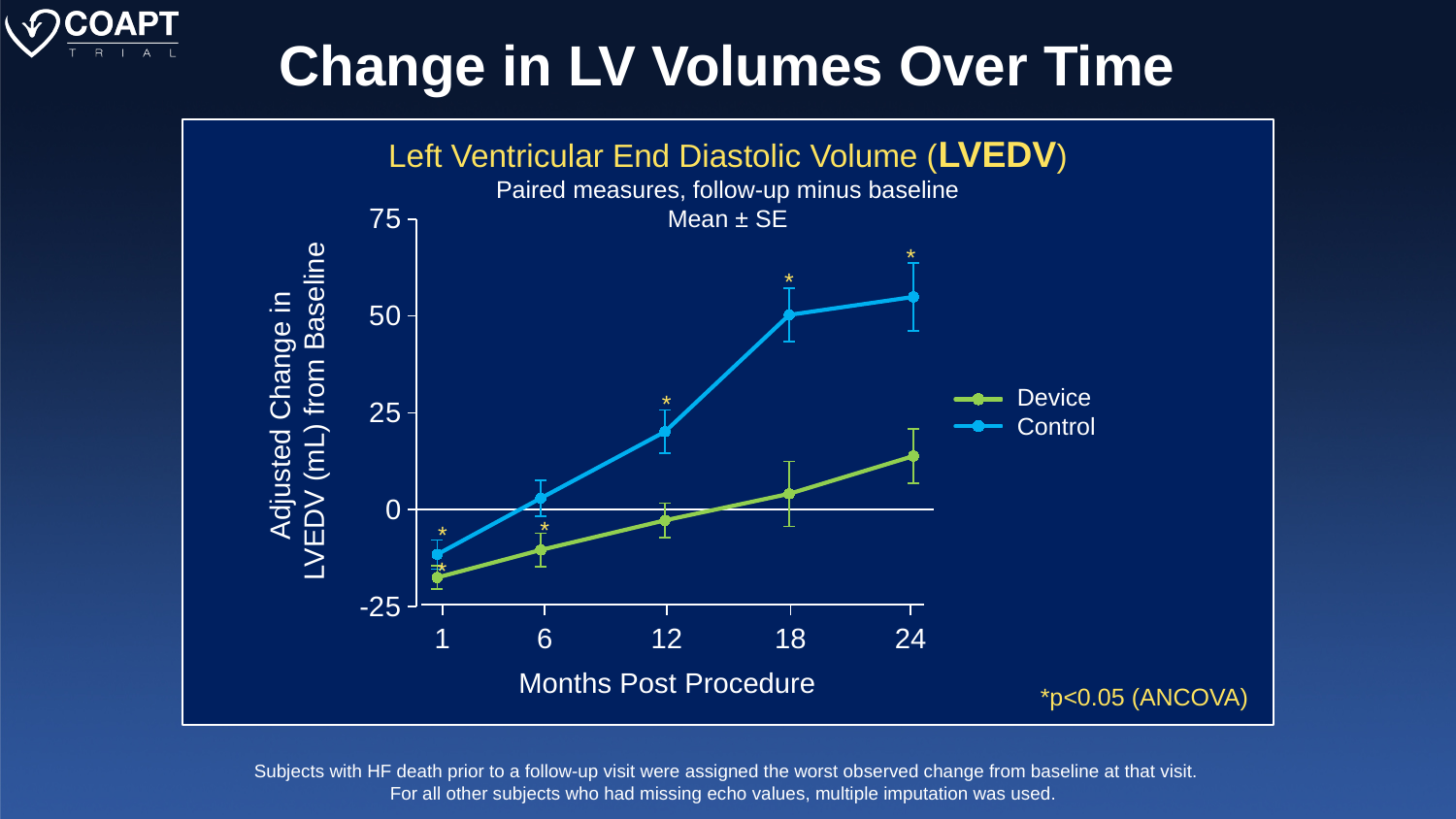
Is the value for Device at 1 month greater or less than 0? less What is the label of the x axis? Months Post Procedure Which series has the larger value at 24 months post procedure, Device or Control? Control Is the value for Device at 24 months greater or less than 25? less Is the value for Control at 12 months greater or less than 25? less How many series does the legend list? 2 Which colour is used for the Device series? Green Which series has the larger value at 12 months post procedure, Device or Control? Control What kind of chart is shown on the slide? Line chart Do the values for the Control series rise or fall from 1 month to 24 months? Rise How many time points are plotted along the x axis? 5